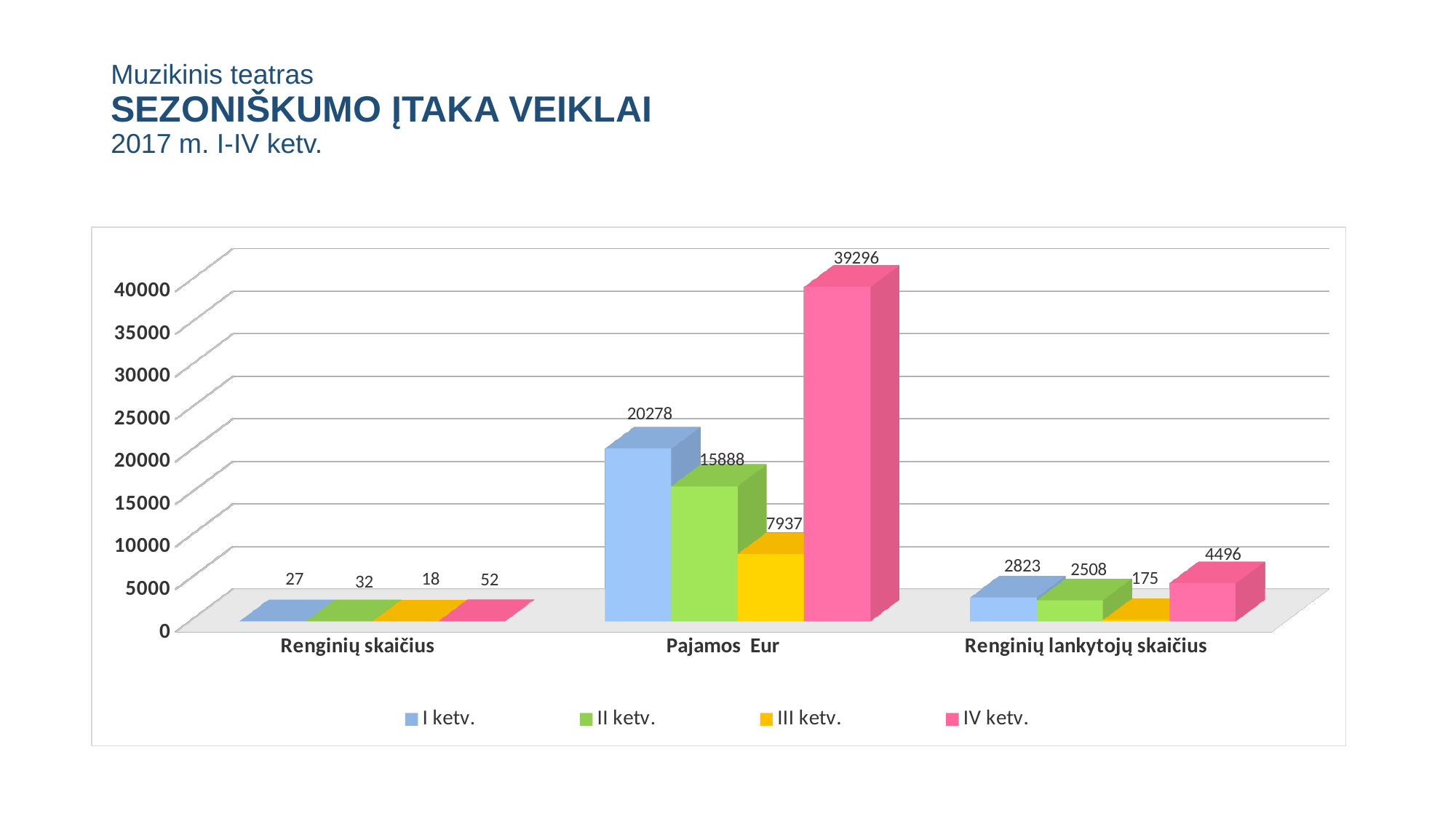
How many categories are shown on the x axis? 3 What is the value for III ketv. in the Renginių skaičius category? 18 Which quarter has the lowest value in the Renginių lankytojų skaičius category? III ketv. Which is larger in the Renginių skaičius category: the value for I ketv. or the value for II ketv.? II ketv. How many series does the legend list? 4 What kind of chart is shown on the slide? bar chart Is the value for II ketv. in the Pajamos Eur category greater or less than 20000? less What is the value for IV ketv. in the Pajamos Eur category? 39296 Which quarter has the highest value in the Pajamos Eur category? IV ketv. What is the difference between the IV ketv. and I ketv. values in the Pajamos Eur category? 19018 What is the difference between the I ketv. and II ketv. values in the Renginių lankytojų skaičius category? 315 What is the value for I ketv. in the Renginių lankytojų skaičius category? 2823